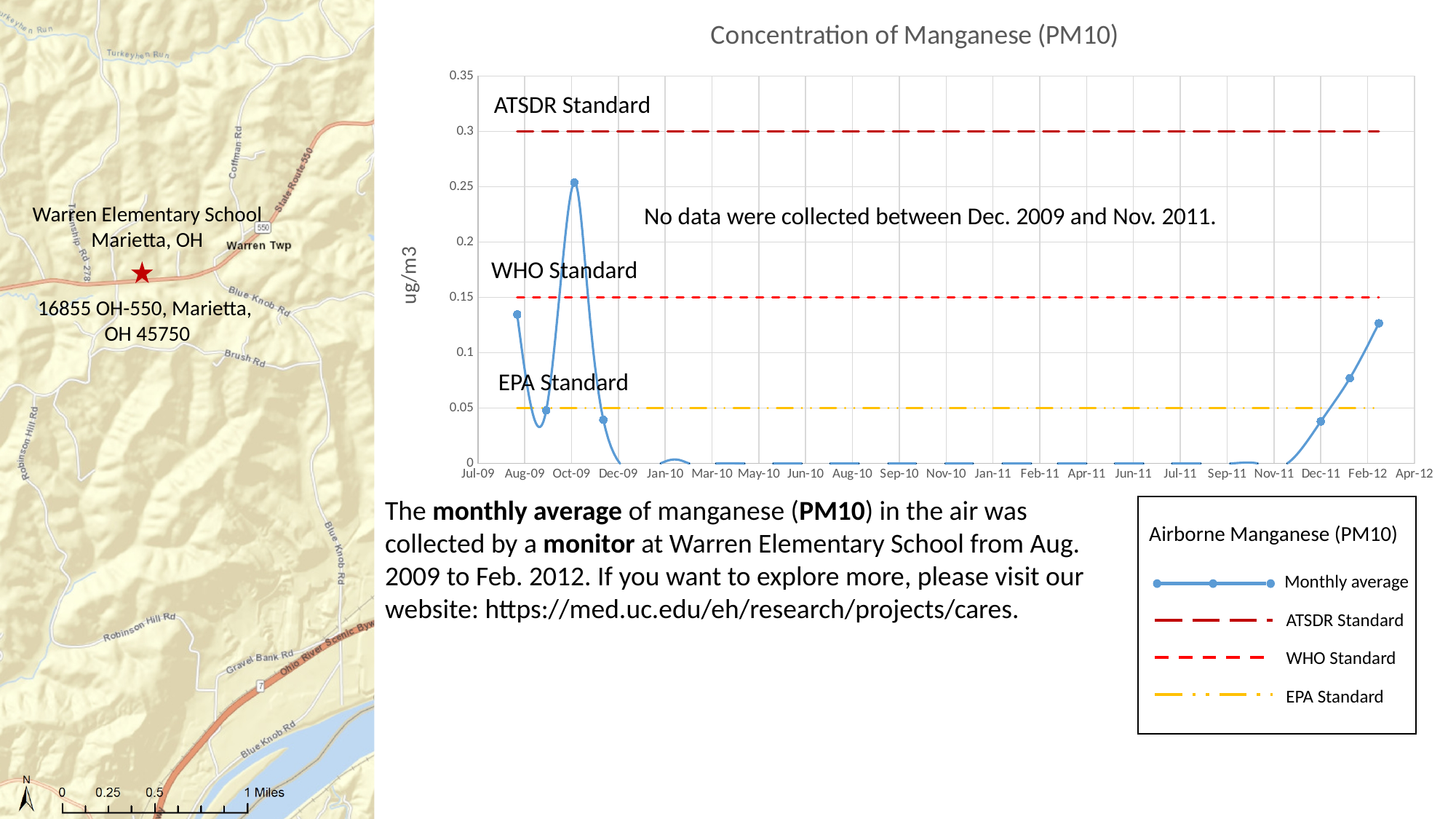
Does the monthly average rise or fall from Dec-11 to Feb-12? rise What is the value of the ATSDR Standard line on the chart? 0.3 Which is larger, the monthly average for Dec-11 or for Feb-12? Feb-12 What is the title of the chart? Concentration of Manganese (PM10) How many series does the chart legend list? 4 Is the monthly average for Oct-09 greater or less than 0.2? greater Is the monthly average for Aug-09 greater or less than 0.1? greater What is the value of the WHO Standard line on the chart? 0.15 Is the monthly average for Oct-09 greater or less than 0.3? less What kind of chart is shown on the slide? line chart What is the value of the EPA Standard line on the chart? 0.05 In which month is the monthly average of manganese highest? Oct-09